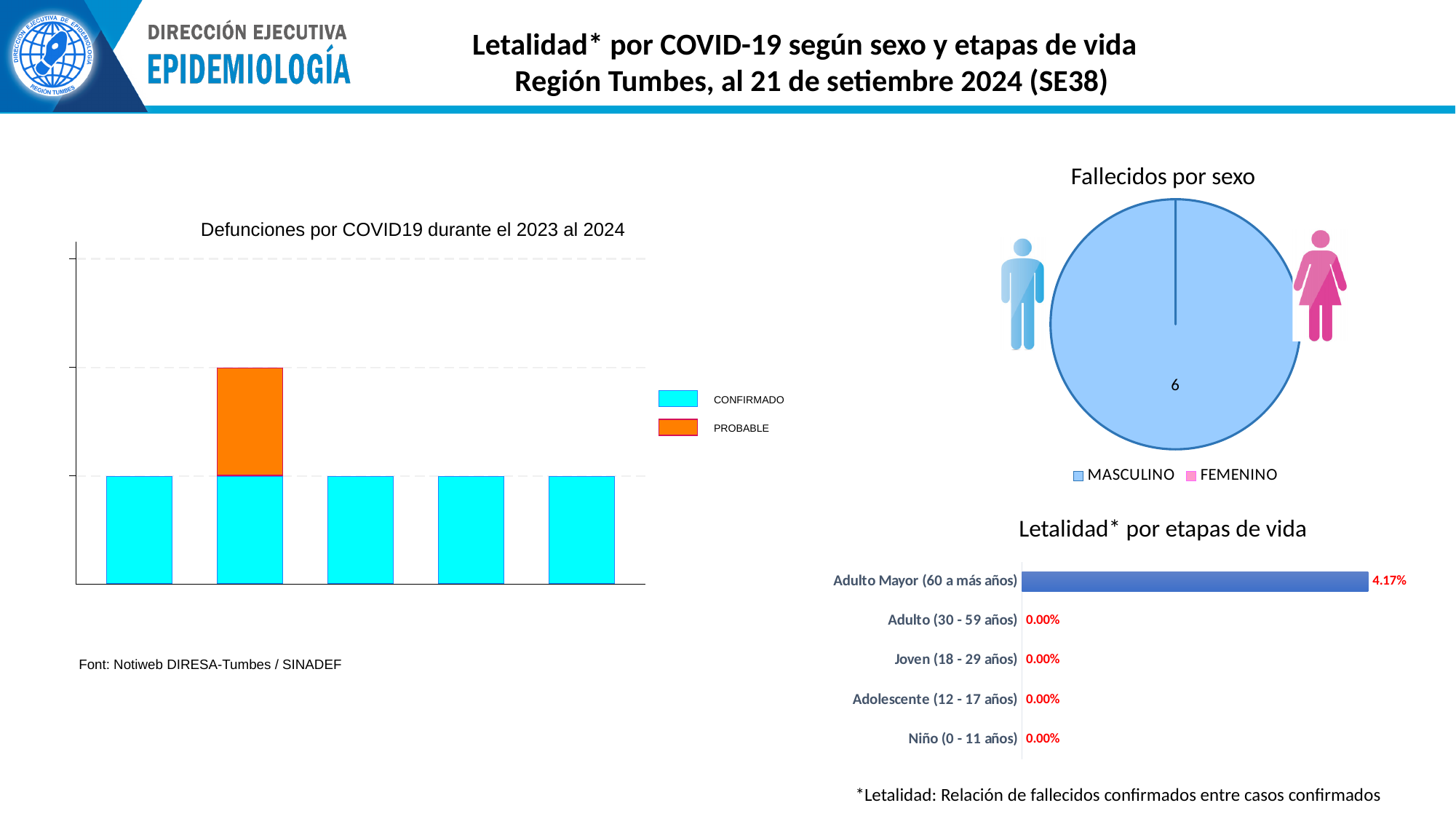
What kind of chart is 'Fallecidos por sexo'? Pie chart In the 'Letalidad* por etapas de vida' chart, what is the value for Joven (18 - 29 años)? 0.00% In the 'Letalidad* por etapas de vida' chart, which age group has the highest value? Adulto Mayor (60 a más años) In the 'Letalidad* por etapas de vida' chart, what is the value for Adulto Mayor (60 a más años)? 4.17% In the 'Fallecidos por sexo' chart, what value is shown for MASCULINO? 6 How many series does the legend of the 'Fallecidos por sexo' chart list? 2 What are the two legend entries of the 'Defunciones por COVID19 durante el 2023 al 2024' chart? CONFIRMADO and PROBABLE How many bars are shown in the 'Defunciones por COVID19 durante el 2023 al 2024' chart? 5 In the 'Letalidad* por etapas de vida' chart, which is larger: the value for Adulto Mayor (60 a más años) or the value for Niño (0 - 11 años)? Adulto Mayor (60 a más años) In the 'Letalidad* por etapas de vida' chart, how many age groups are shown? 5 In the 'Letalidad* por etapas de vida' chart, what is the difference between the value for Adulto Mayor (60 a más años) and the value for Adulto (30 - 59 años)? 4.17% What kind of chart is 'Letalidad* por etapas de vida'? Bar chart